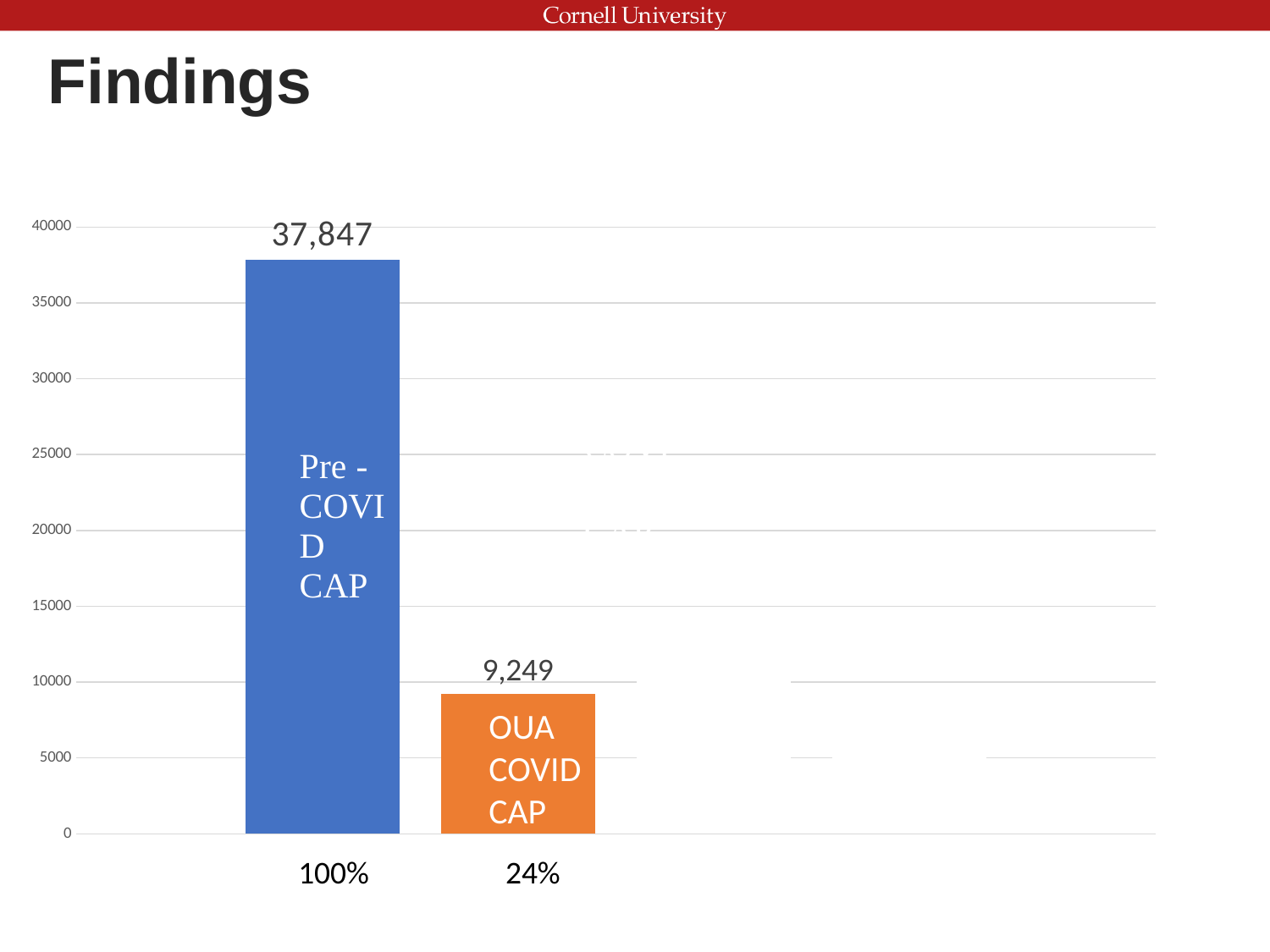
What kind of chart is shown on the slide? Bar chart What is the value shown for the OUA COVID CAP bar? 9,249 Which bar has the lowest value? OUA COVID CAP Which bar has the highest value? Pre-COVID CAP Is the value for OUA COVID CAP greater or less than 10000? less Which is larger, the Pre-COVID CAP value or the OUA COVID CAP value? Pre-COVID CAP What percentage label is shown beneath the OUA COVID CAP bar? 24% What is the difference between the Pre-COVID CAP value and the OUA COVID CAP value? 28,598 What is the value shown for the Pre-COVID CAP bar? 37,847 How many bars are plotted in the chart? 2 What colour is the Pre-COVID CAP bar? Blue Is the value for Pre-COVID CAP greater or less than 35000? greater